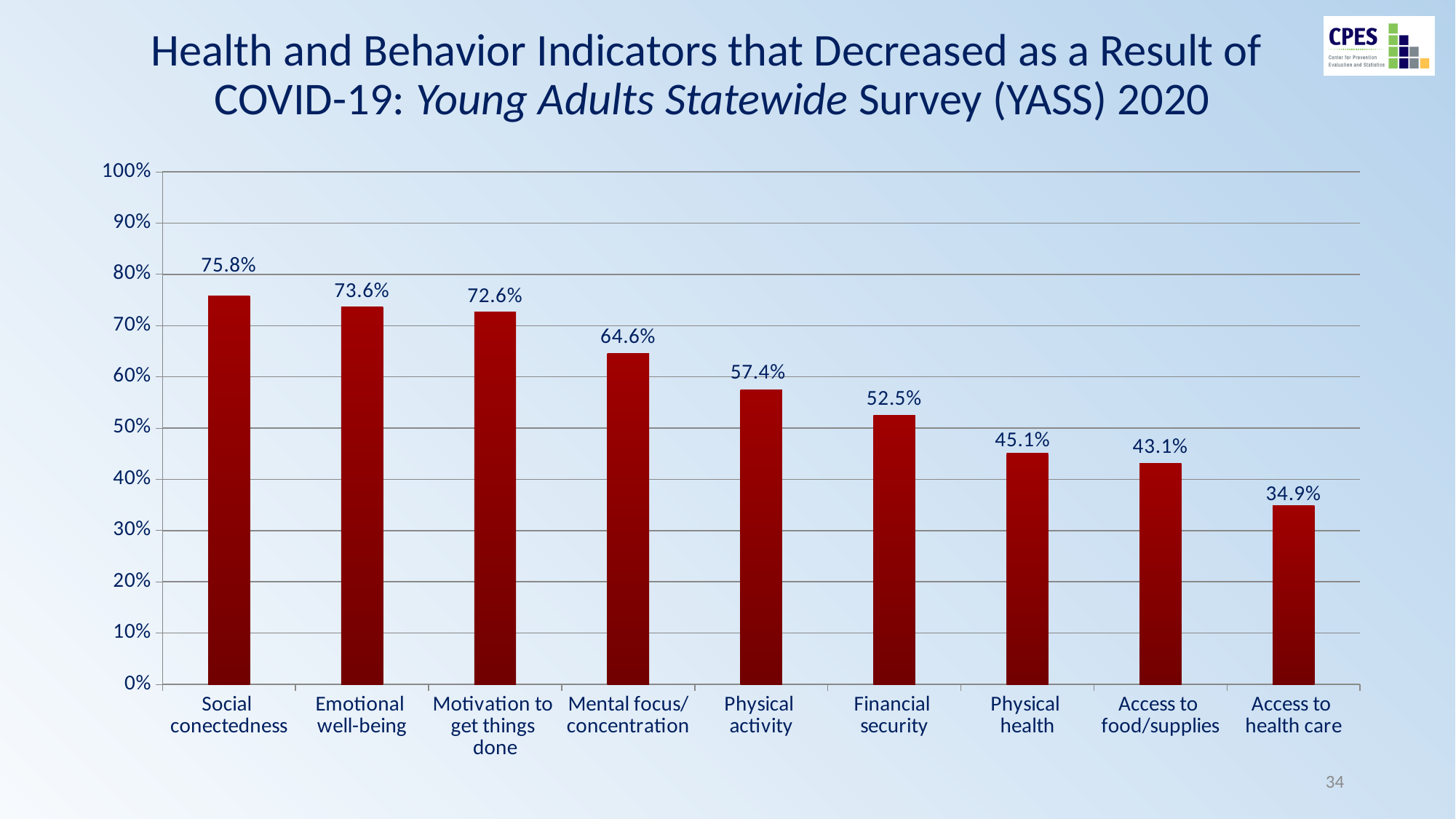
Which category has the lowest value? Access to health care What percentage is shown for Social conectedness? 75.8% Is the value for Access to food/supplies greater or less than 50%? less What percentage is shown for Financial security? 52.5% Do the values rise or fall from left to right along the x axis? fall How many categories are shown on the chart? 9 What is the value for Access to health care? 34.9% Which category has the highest value? Social conectedness Which is larger, the value for Emotional well-being or the value for Mental focus/concentration? Emotional well-being What kind of chart is shown on the slide? bar chart What is the value for Motivation to get things done? 72.6% What is the difference between the values for Physical activity and Physical health? 12.3%